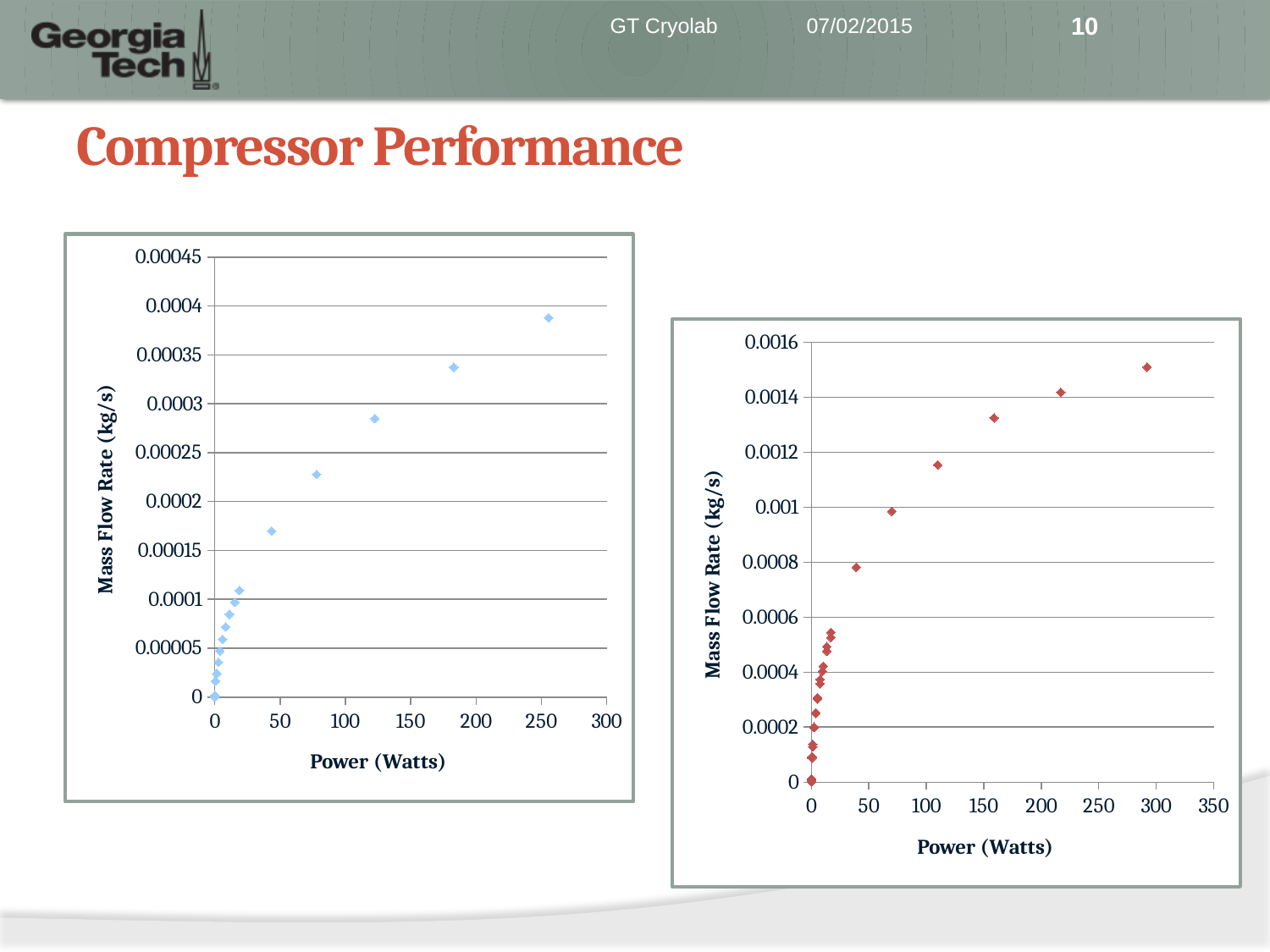
What kind of chart is the right chart on the slide? scatter chart What kind of chart is the left chart on the slide? scatter chart What is the x-axis label of the left chart? Power (Watts) In the left chart, is the mass flow rate of the point near 45 Watts greater or less than 0.0002? less In the left chart, is the mass flow rate of the point near 125 Watts greater or less than 0.00025? greater In the right chart, does the mass flow rate rise or fall as power increases? rise In the right chart, is the mass flow rate of the point near 110 Watts greater or less than 0.001? greater In the right chart, which point has the higher mass flow rate: the one near 290 Watts or the one near 215 Watts? the one near 290 Watts What is the y-axis label of the right chart? Mass Flow Rate (kg/s) In the left chart, does the mass flow rate rise or fall as power increases? rise